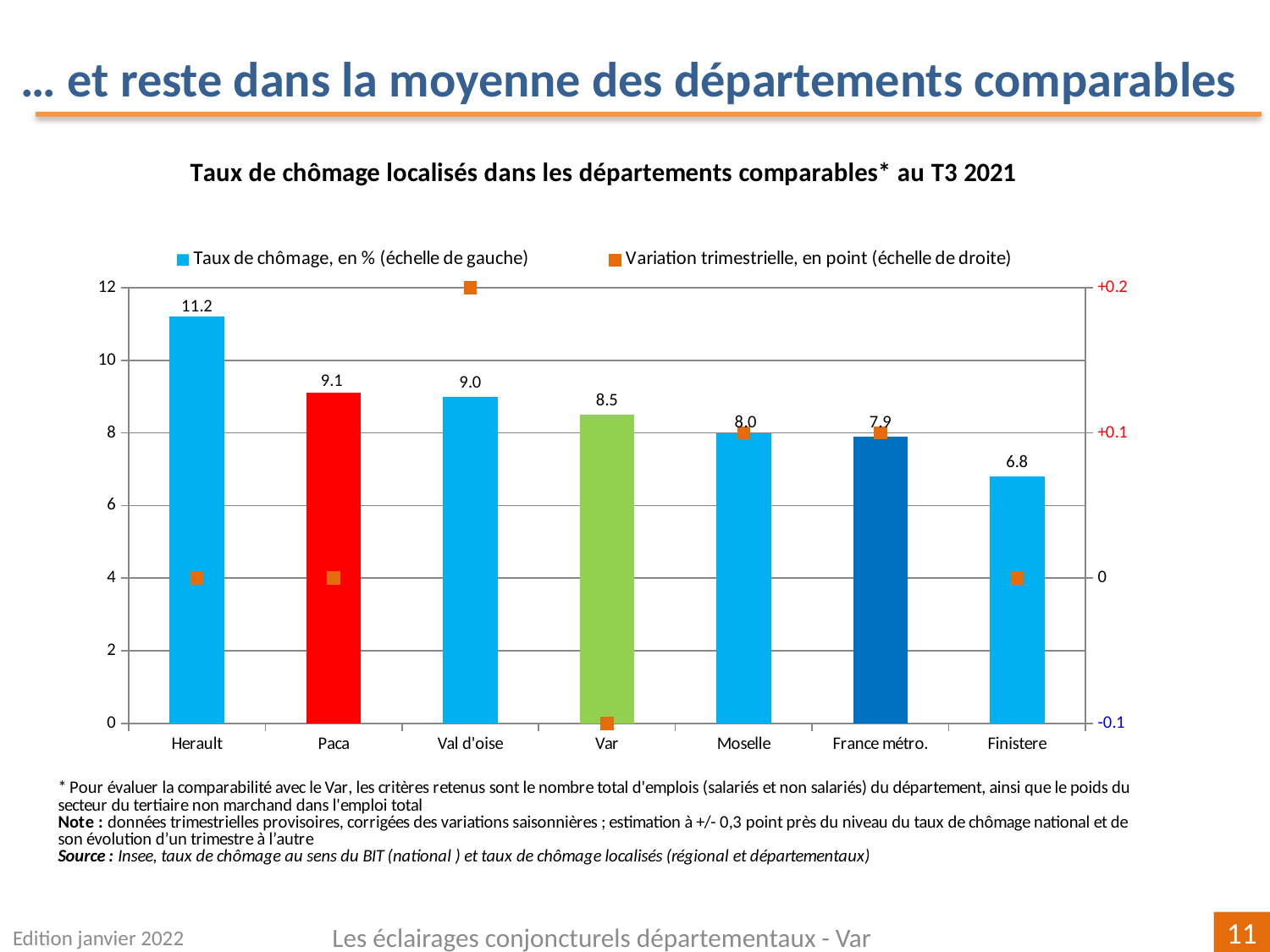
What kind of chart is used to show the unemployment rates? Bar chart How many categories are shown on the x axis? 7 What is the quarterly variation (Variation trimestrielle) for Val d'oise, read on the right axis? +0.2 Which category has the highest unemployment rate? Herault What is the difference between the unemployment rates of Herault and Finistere? 4.4 How many series does the legend list? 2 What is the unemployment rate (Taux de chômage) for France métro.? 7.9 Which category has the lowest unemployment rate? Finistere What is the unemployment rate (Taux de chômage) for Herault? 11.2 What is the unemployment rate (Taux de chômage) for Var? 8.5 Which has a higher unemployment rate, Paca or Moselle? Paca What is the quarterly variation (Variation trimestrielle) for Var, read on the right axis? -0.1